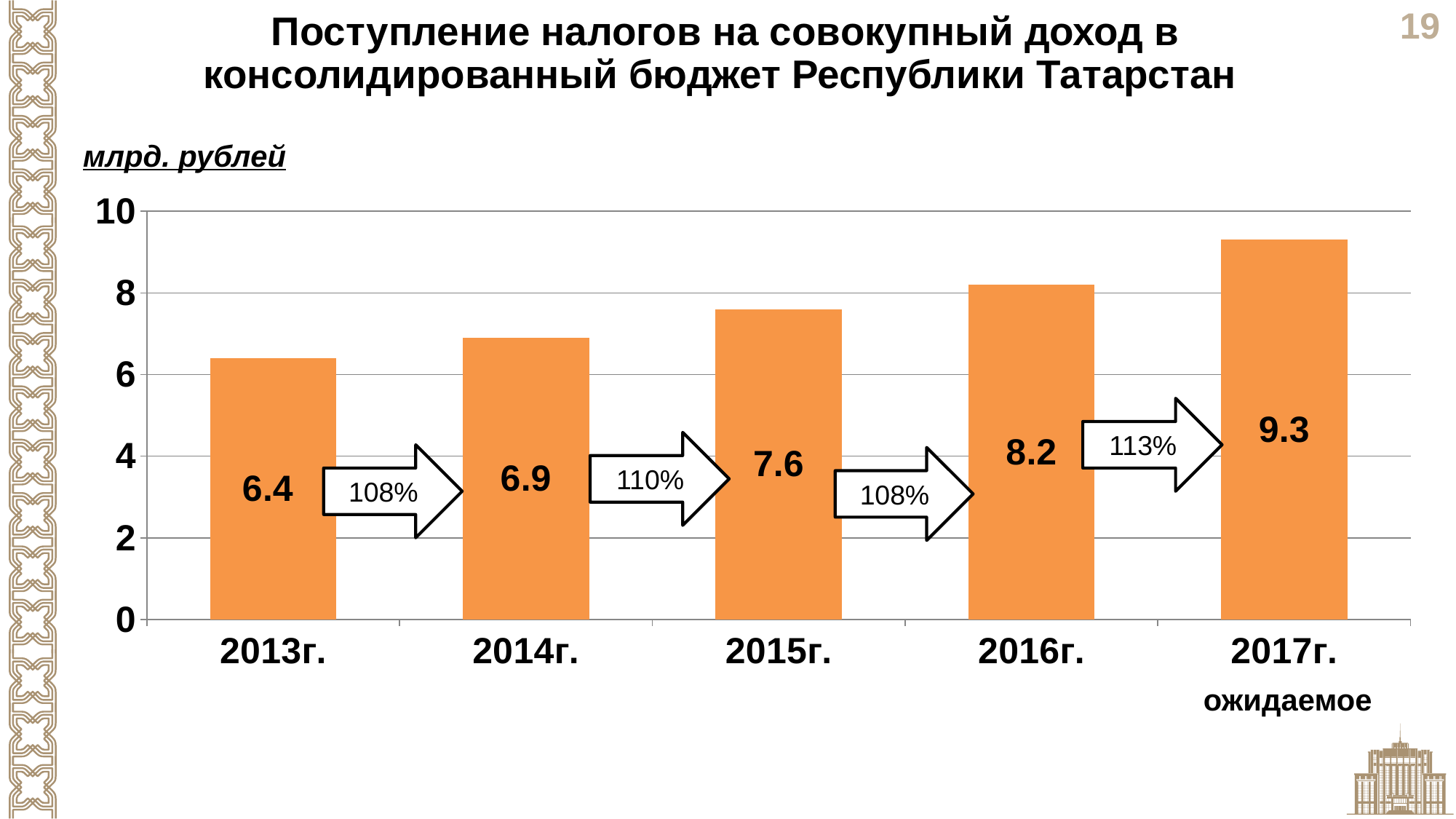
What unit is stated above the chart? млрд. рублей What is the difference between the values for 2016г. and 2014г.? 1.3 Is the value for 2016г. greater or less than 8? greater What is the value for 2013г.? 6.4 Do the values rise or fall from 2013г. to 2017г.? rise What is the value for 2015г.? 7.6 How many years are shown on the chart? 5 What kind of chart is shown on the slide? bar chart What is the value for 2017г. (ожидаемое)? 9.3 Which year has the highest value? 2017г. Which is larger, the value for 2014г. or the value for 2015г.? 2015г. Which year has the lowest value? 2013г.